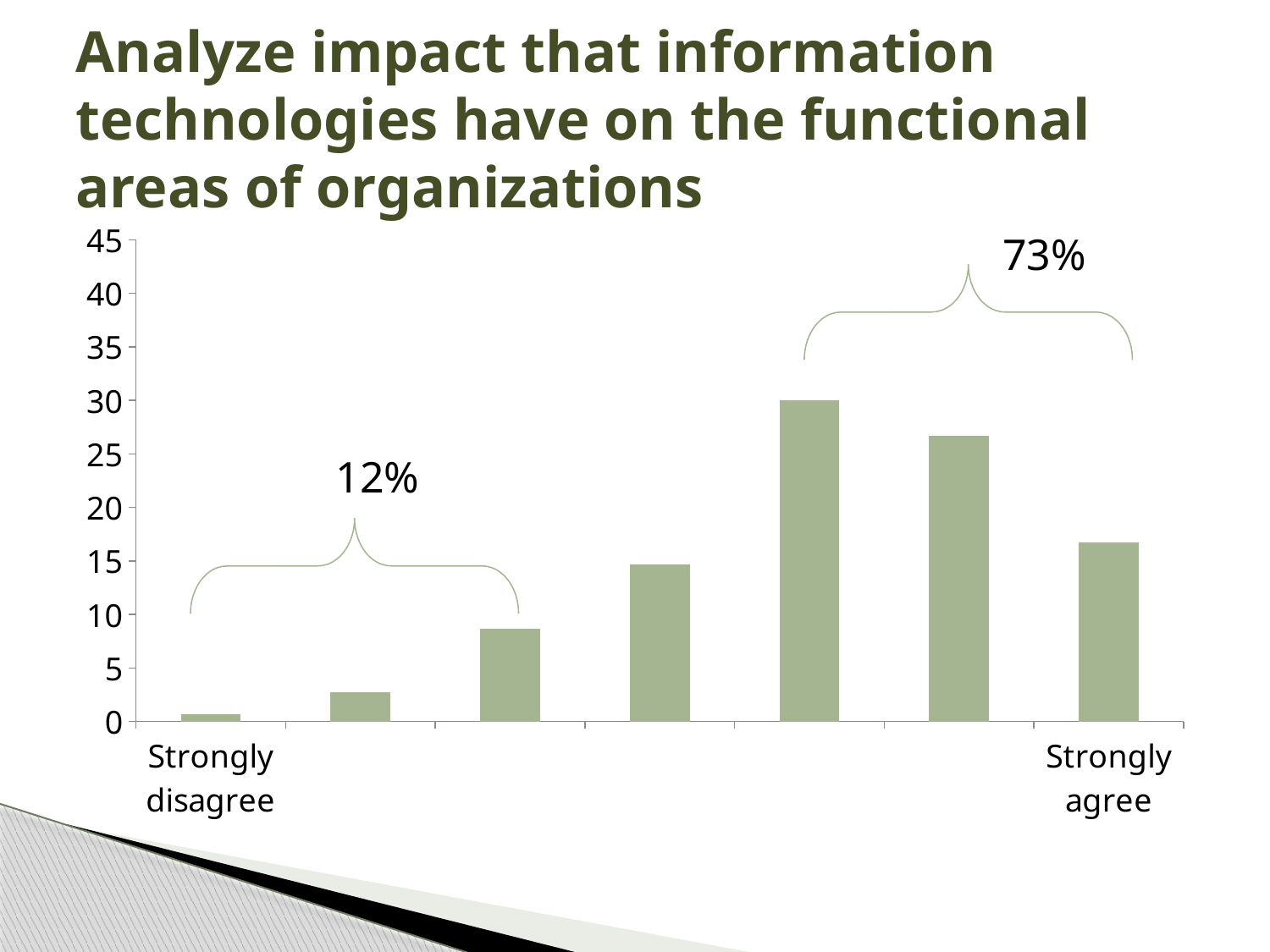
Is the value for Strongly agree greater or less than 20? less What percentage is shown above the bracket covering the three rightmost bars? 73% Is the value for Strongly disagree greater or less than 5? less What kind of chart is shown on the slide? bar chart Which is larger, the value for Strongly agree or the value for Strongly disagree? Strongly agree What percentage is shown above the bracket covering the three leftmost bars? 12% Which category has the lowest value in the chart? Strongly disagree How many bars are plotted in the chart? 7 Which bar is the tallest in the chart? the fifth bar from the left Which is larger, the fifth bar from the left or the sixth bar from the left? the fifth bar from the left Is the value of the third bar from the left greater or less than 10? less